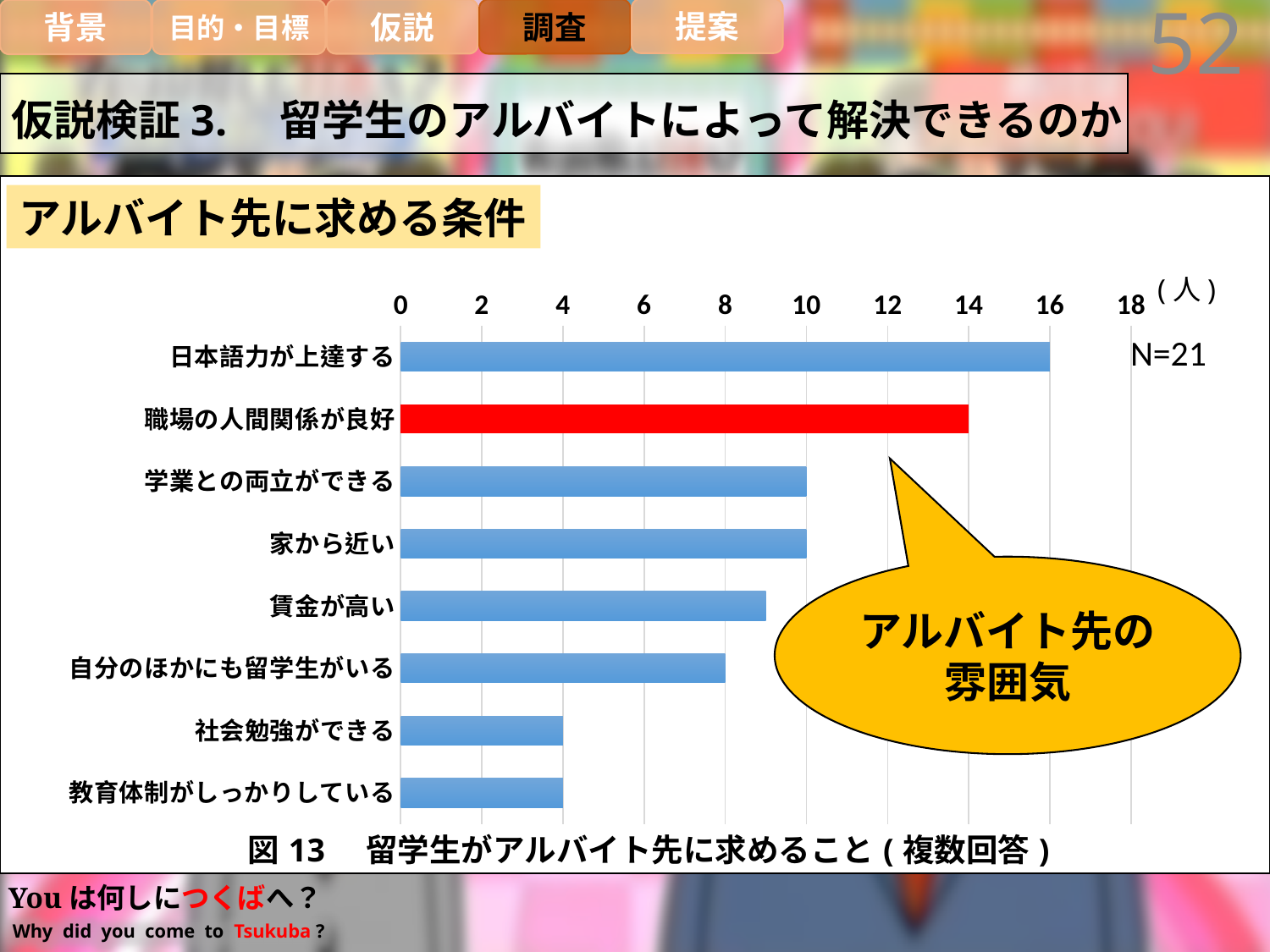
Is the value for 賃金が高い greater or less than 8? greater Is the value for 賃金が高い greater or less than 10? less How many categories are shown in the chart? 8 What is the difference between the values for 日本語力が上達する and 職場の人間関係が良好? 2 Which category has the highest value? 日本語力が上達する Which is larger, the value for 学業との両立ができる or the value for 社会勉強ができる? 学業との両立ができる What is the value for 自分のほかにも留学生がいる? 8 What kind of chart is shown on the slide? bar chart What is the value for 職場の人間関係が良好? 14 Which category's bar is coloured red? 職場の人間関係が良好 What is the sample size (N) shown on the chart? N=21 What is the value for 日本語力が上達する? 16